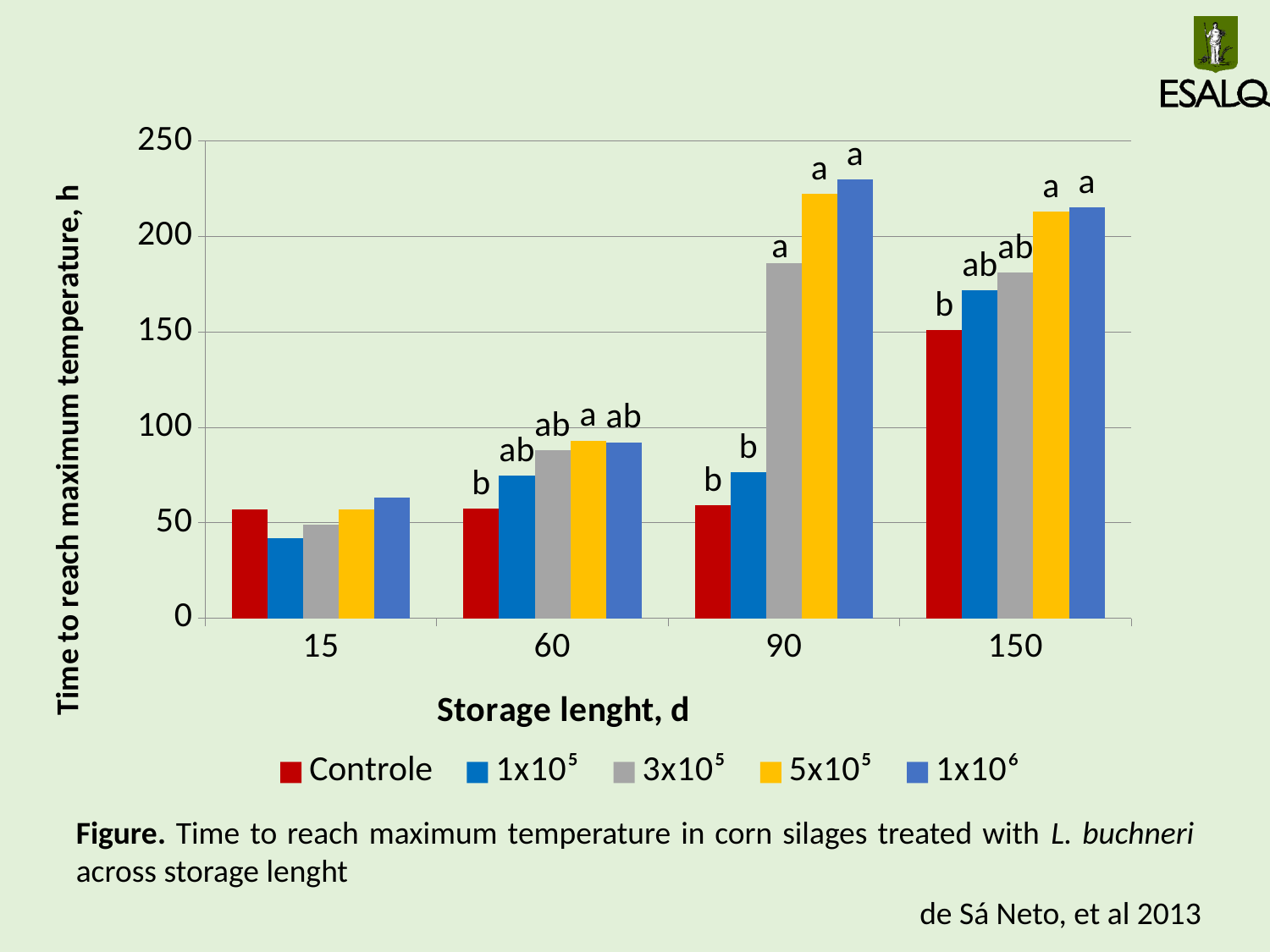
What is the title of the y axis? Time to reach maximum temperature, h How many series does the legend list? 5 Which treatment has the lowest value at 150 d? Controle At 90 d, which is larger: the value for 3x10^5 or the value for 1x10^5? 3x10^5 Is the value for Controle at 150 d greater or less than 100? greater How many storage length categories are shown on the x axis? 4 Which treatment has the lowest value at 15 d? 1x10^5 Do the values for 1x10^5 rise or fall as storage length increases from 15 d to 150 d? rise What kind of chart is shown on the slide? bar chart Is the value for 1x10^6 at 90 d greater or less than 200? greater Is the value for 5x10^5 at 60 d greater or less than 100? less